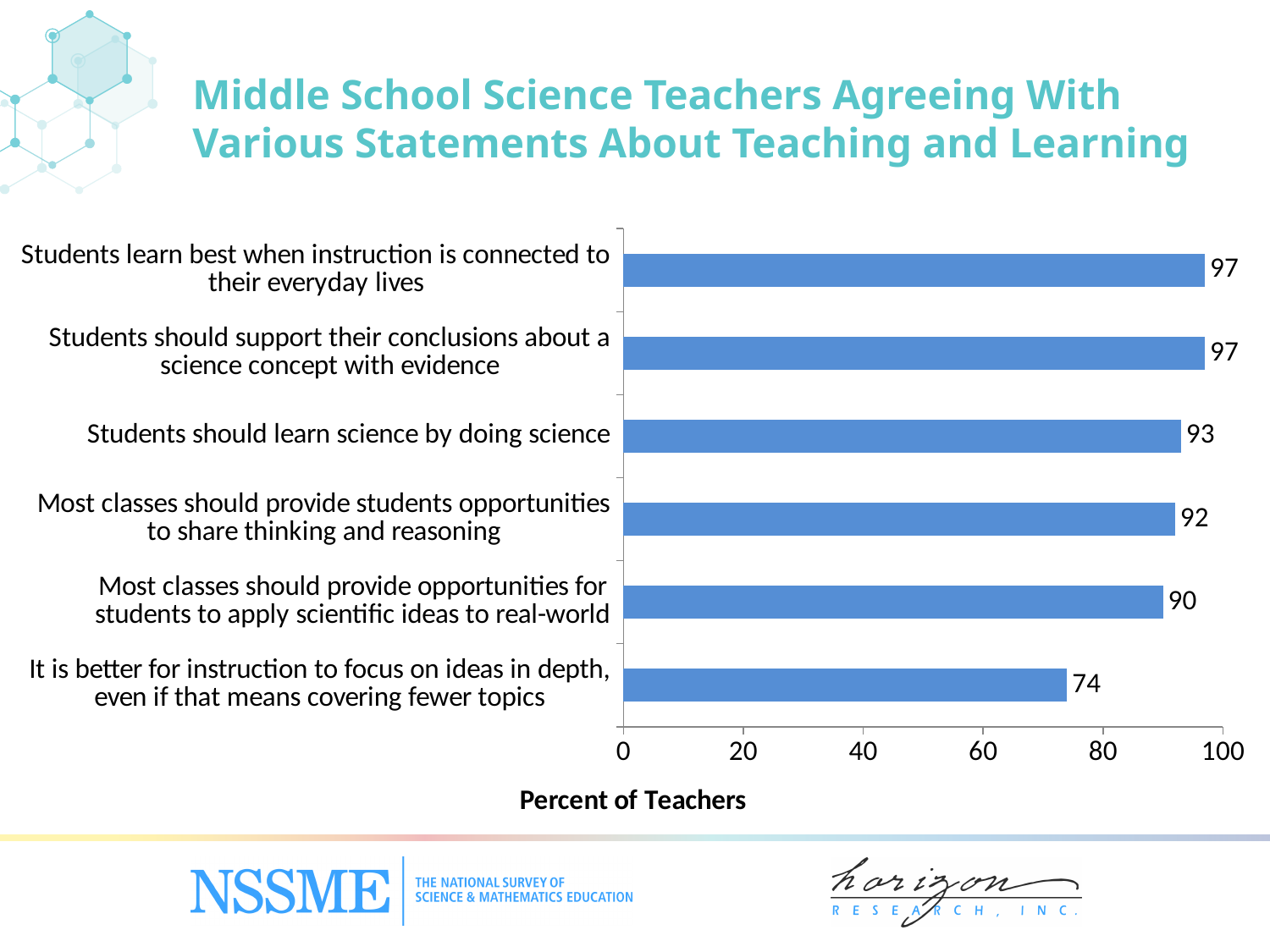
What is the difference in percent of teachers between 'Students should support their conclusions about a science concept with evidence' and 'Most classes should provide opportunities for students to apply scientific ideas to real-world'? 7 Is the value for 'It is better for instruction to focus on ideas in depth, even if that means covering fewer topics' greater or less than 80? less What percent of teachers agree that it is better for instruction to focus on ideas in depth, even if that means covering fewer topics? 74 How many statements are shown in the chart? 6 What kind of chart is shown on the slide? Bar chart What percent of teachers agree that most classes should provide students opportunities to share thinking and reasoning? 92 What is the difference in percent of teachers between 'Students should learn science by doing science' and 'It is better for instruction to focus on ideas in depth, even if that means covering fewer topics'? 19 What is the label of the horizontal axis? Percent of Teachers Which has a higher percent of teachers agreeing: 'Students should learn science by doing science' or 'Most classes should provide students opportunities to share thinking and reasoning'? Students should learn science by doing science What percent of teachers agree that most classes should provide opportunities for students to apply scientific ideas to real-world? 90 What percent of teachers agree that students should learn science by doing science? 93 Which statement has the lowest percent of teachers agreeing? It is better for instruction to focus on ideas in depth, even if that means covering fewer topics